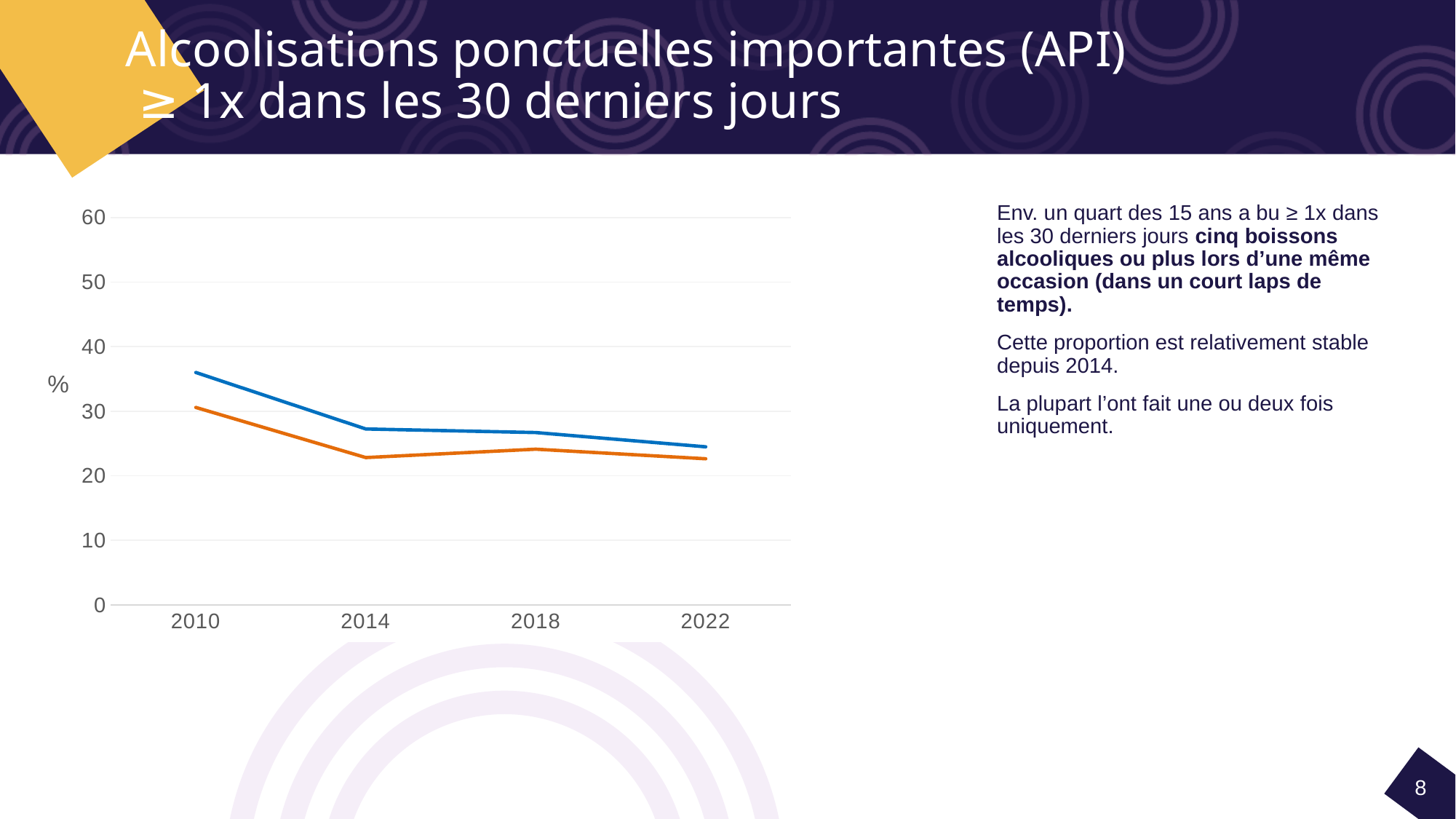
How many years are shown on the x axis of the chart? 4 In which year does the blue line reach its highest value? 2010 How many lines are plotted on the chart? 2 What kind of chart is shown on the slide? line chart Is the value of the blue line in 2014 greater or less than 30? less Is the value of the orange line in 2014 greater or less than 20? greater Is the value of the blue line in 2010 greater or less than 30? greater What unit is shown on the y axis of the chart? % In 2010, which line has the higher value, the blue line or the orange line? blue line Do the values of the blue line rise or fall from 2010 to 2022? fall What is the first year shown on the x axis? 2010